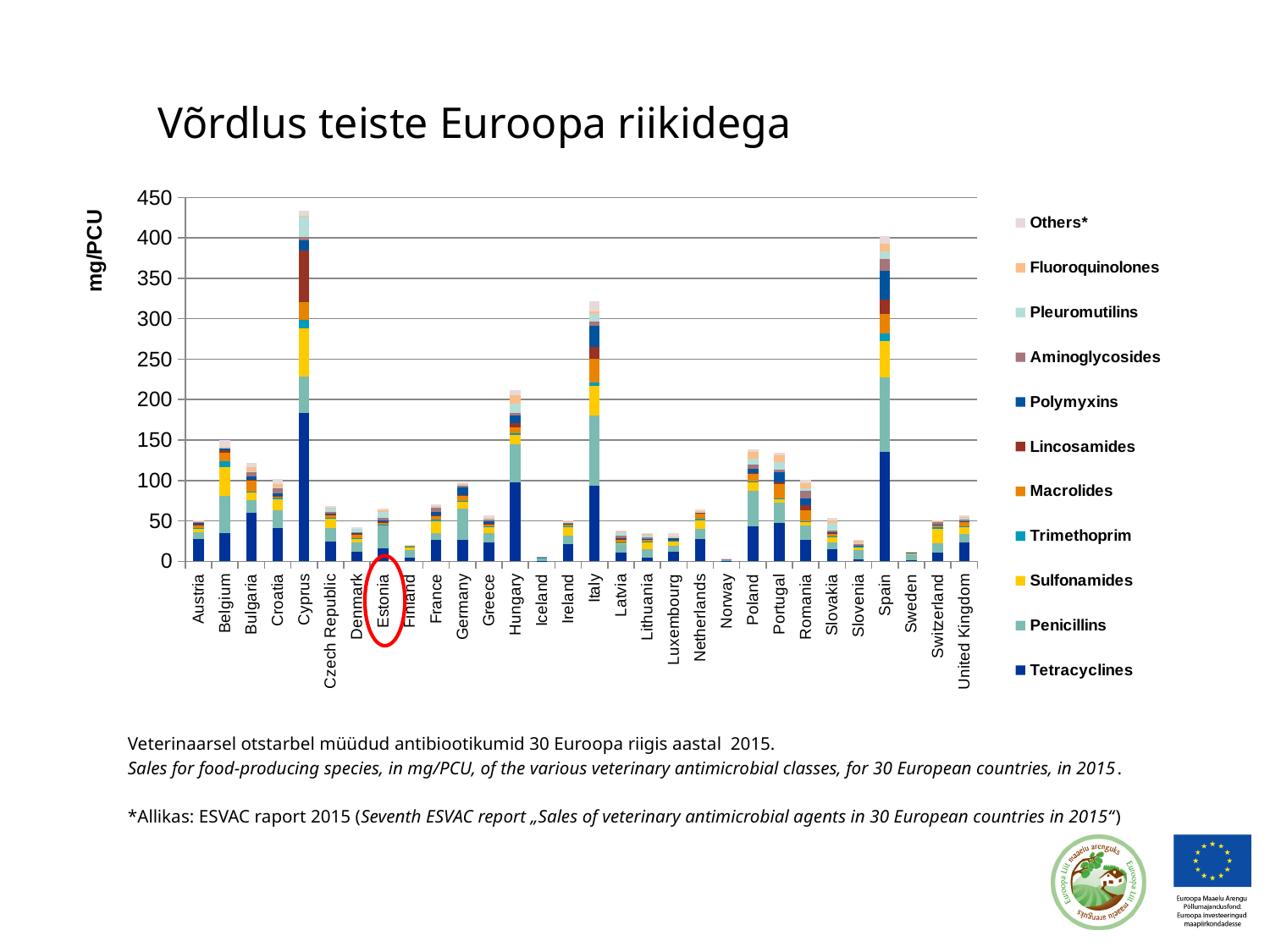
Is the total value for Estonia greater or less than 100? less Which country has the highest total bar in the chart? Cyprus Is the total value for Hungary greater or less than 200? greater Which has a larger total bar, Italy or Hungary? Italy Is the total value for Cyprus greater or less than 400? greater What is the label on the y axis of the chart? mg/PCU What kind of chart is shown on the slide? stacked bar chart How many series does the chart's legend list? 11 Which country on the x axis is circled in red? Estonia How many countries are shown on the x axis of the chart? 30